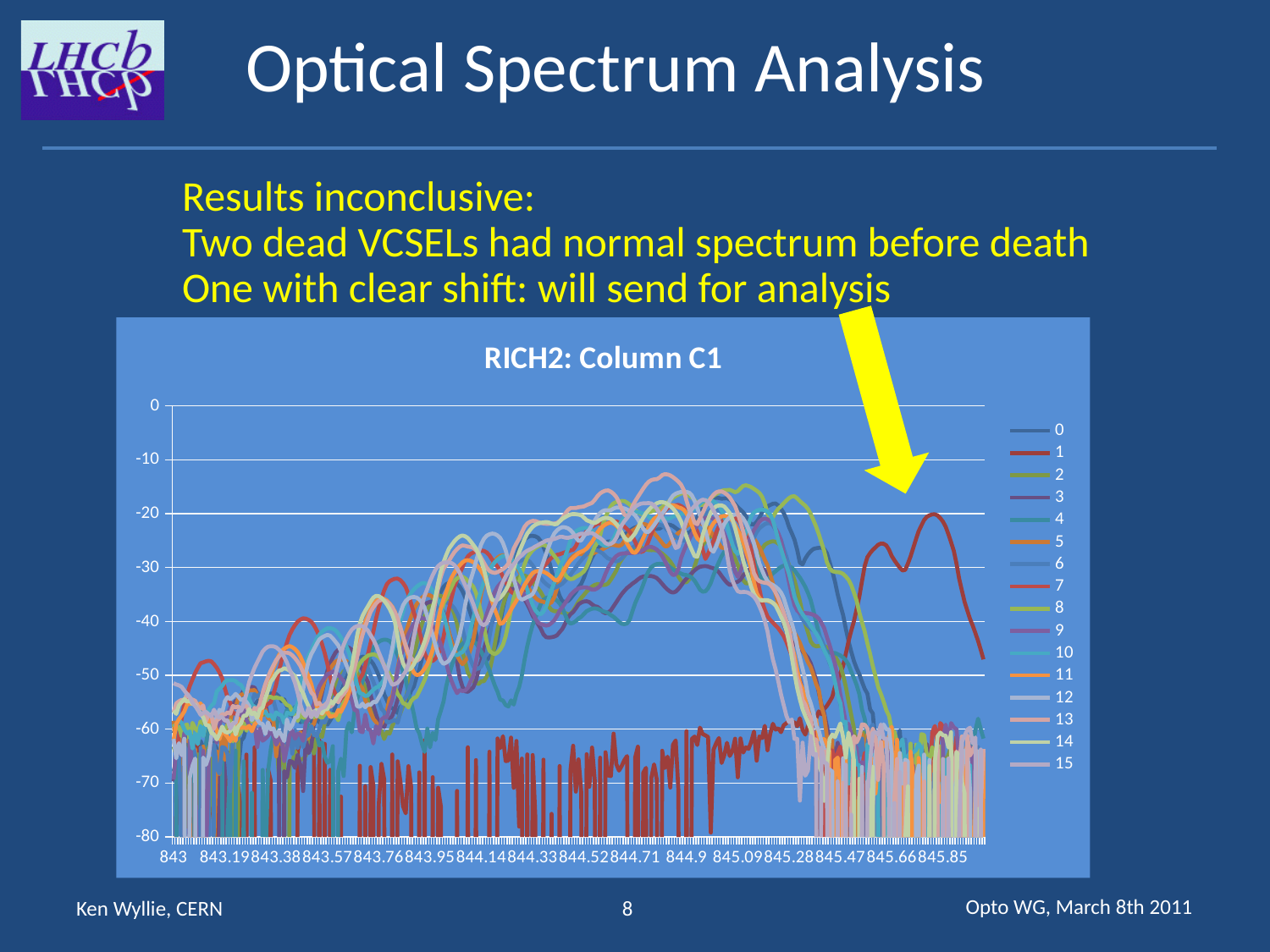
Is the highest peak reached by any curve greater or less than -10? less What is the first x-axis tick label? 843 What is the last series label in the legend? 15 How many series does the chart's legend list? 16 At the left edge of the chart (x = 843), are the curve values greater or less than -50? less What is the lowest value shown on the y axis? -80 What is the title of the chart? RICH2: Column C1 What is the first series label in the legend? 0 What is the last x-axis tick label? 845.85 What is the highest value shown on the y axis? 0 How many tick labels are printed along the x axis? 16 What kind of chart is shown on the slide? line chart